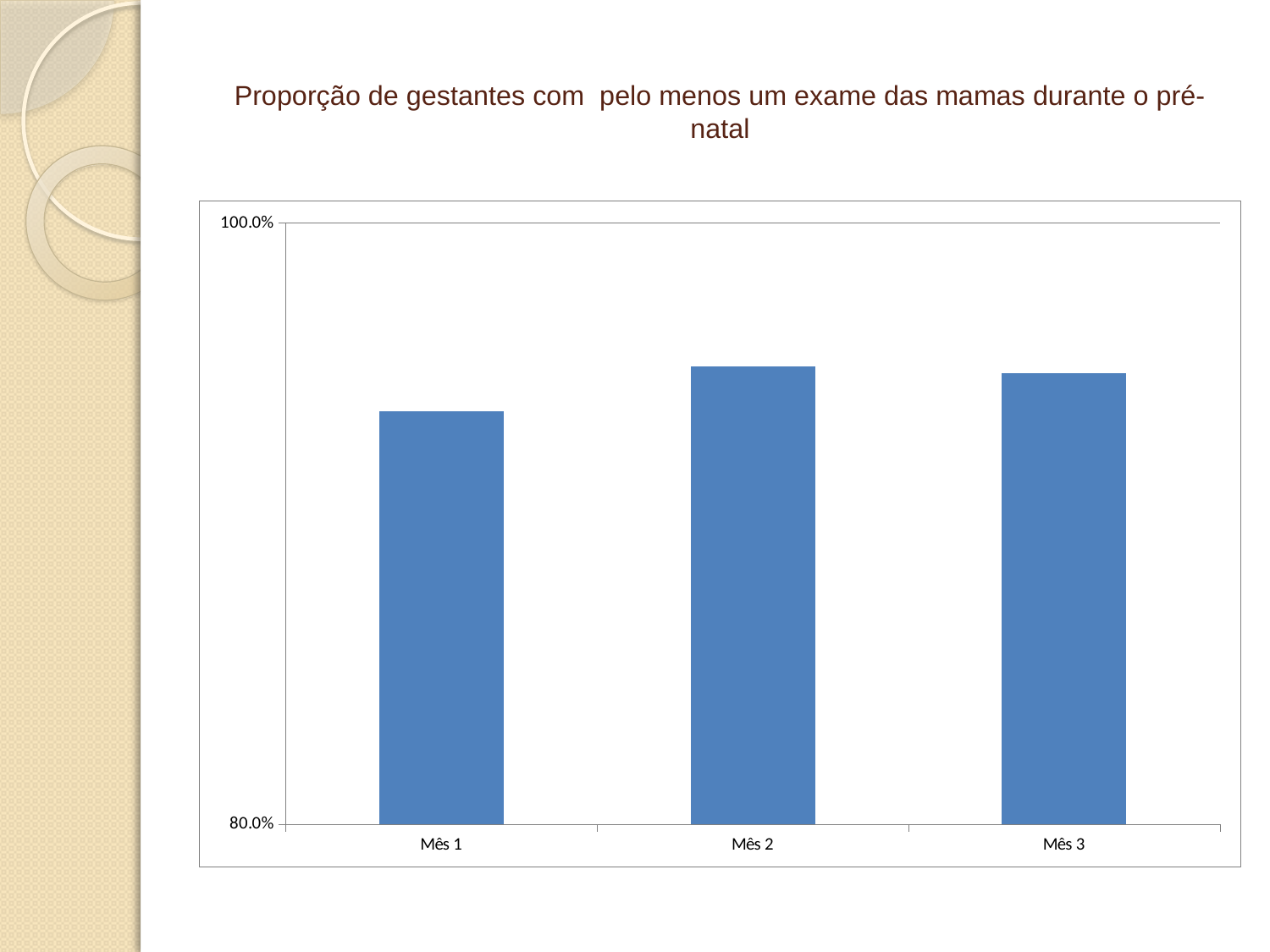
Which category has the lowest value in the chart? Mês 1 What kind of chart is shown on the slide? bar chart Is the value for Mês 2 greater or less than 100.0%? less How many categories are plotted on the x axis of the chart? 3 What is the lowest value shown on the y axis of the chart? 80.0% Does the value rise or fall from Mês 1 to Mês 2? rise Is the value for Mês 3 greater or less than 80.0%? greater What is the title of the slide above the chart? Proporção de gestantes com pelo menos um exame das mamas durante o pré-natal Is the value for Mês 3 larger or smaller than the value for Mês 1? larger Is the value for Mês 2 larger or smaller than the value for Mês 1? larger Is the value for Mês 1 greater or less than 80.0%? greater